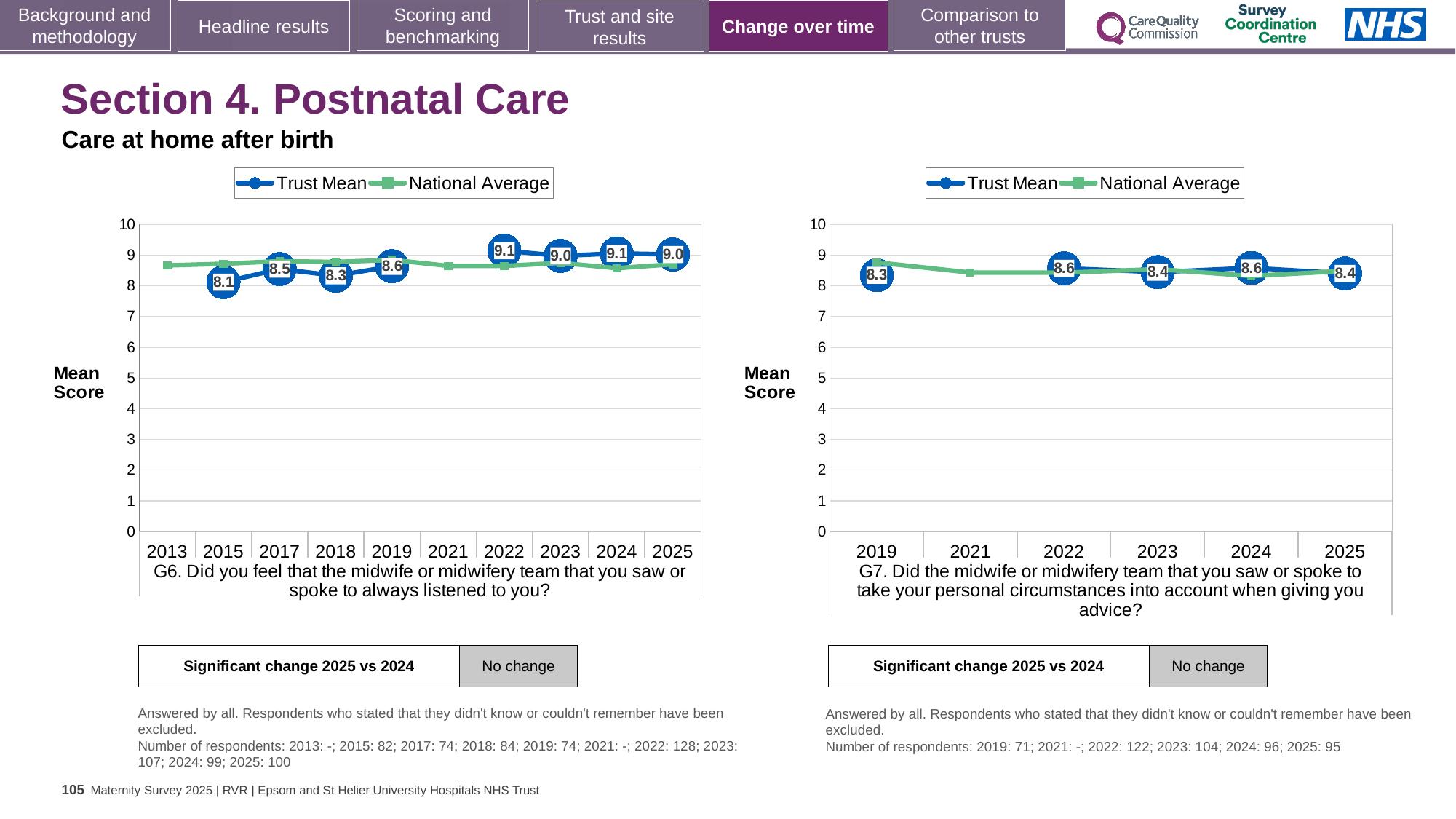
In the right chart (G7), what is the Trust Mean for 2023? 8.4 How many series does the legend of the left chart (G6) list? 2 In the right chart (G7), what is the Trust Mean for 2019? 8.3 How many years are shown on the x axis of the right chart (G7)? 6 In the left chart (G6), is the Trust Mean higher in 2018 or in 2019? 2019 In the left chart (G6), what is the difference between the Trust Mean in 2025 and in 2015? 0.9 In the left chart (G6), what is the Trust Mean for 2022? 9.1 What type of chart is the right chart (G7)? Line chart In the left chart (G6), is the National Average for 2013 greater or less than 8? greater In the right chart (G7), what is the difference between the Trust Mean in 2024 and in 2025? 0.2 In the left chart (G6), what is the Trust Mean for 2015? 8.1 In the left chart (G6), which year has the lowest labelled Trust Mean? 2015